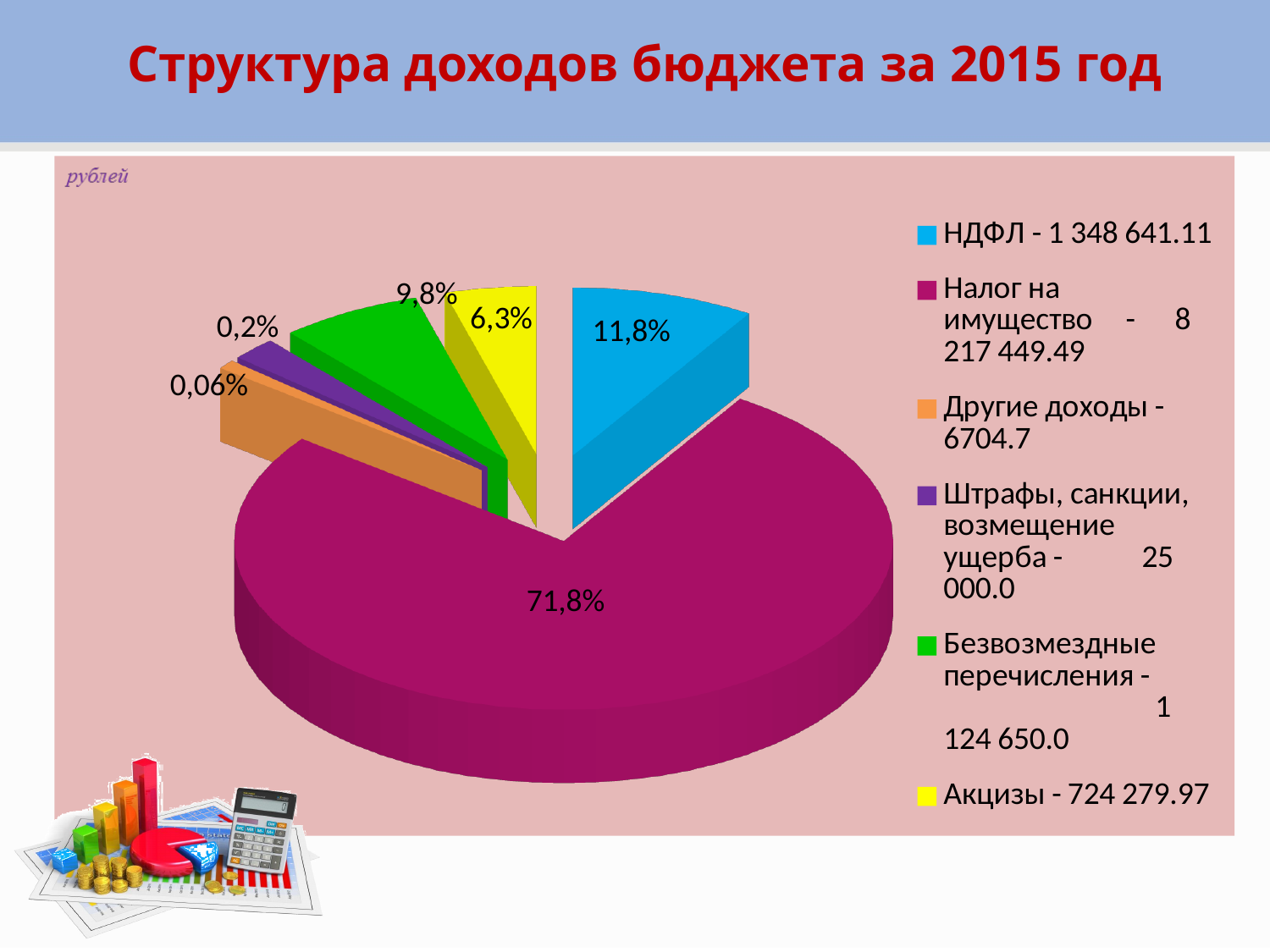
What is the title of the slide's chart? Структура доходов бюджета за 2015 год What share of the pie does НДФЛ take? 11,8% What share of the pie does Акцизы take? 6,3% What share of the pie does Штрафы, санкции, возмещение ущерба take? 0,2% Which category has the largest slice of the pie? Налог на имущество What share of the pie does Налог на имущество take? 71,8% What is the difference in percentage points between the Налог на имущество slice and the НДФЛ slice? 60,0% What kind of chart is shown on the slide? pie chart Which category has the smallest slice of the pie? Другие доходы What share of the pie does Безвозмездные перечисления take? 9,8% How many slices does the pie chart have? 6 Which slice is larger, Безвозмездные перечисления or Акцизы? Безвозмездные перечисления